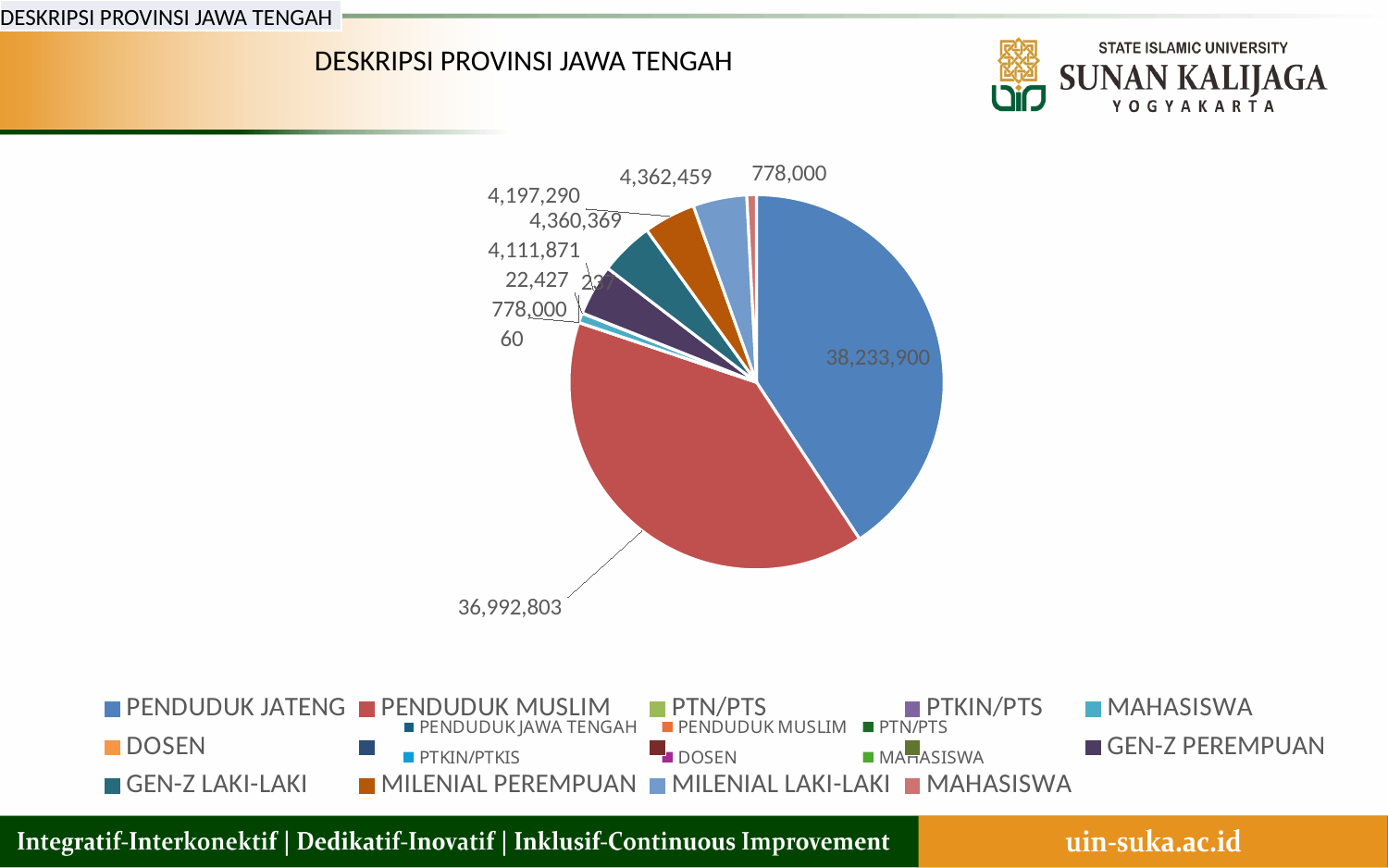
What is the value shown for GEN-Z LAKI-LAKI (teal slice) in the pie chart? 4,360,369 What is the value shown for PENDUDUK JATENG in the pie chart? 38,233,900 Which is larger, the value for PENDUDUK JATENG or the value for PENDUDUK MUSLIM? PENDUDUK JATENG What is the difference between the values for PENDUDUK JATENG and PENDUDUK MUSLIM? 1,241,097 What is the value shown for PENDUDUK MUSLIM in the pie chart? 36,992,803 What is the title of the slide containing the pie chart? DESKRIPSI PROVINSI JAWA TENGAH Which category has the largest slice in the pie chart? PENDUDUK JATENG What is the value shown for MILENIAL PEREMPUAN (orange slice) in the pie chart? 4,197,290 What is the difference between the values for GEN-Z LAKI-LAKI (4,360,369) and GEN-Z PEREMPUAN (4,111,871)? 248,498 How many slices (data labels) does the pie chart have? 11 What is the smallest value printed as a data label on the pie chart? 60 What type of chart is shown on the slide? pie chart